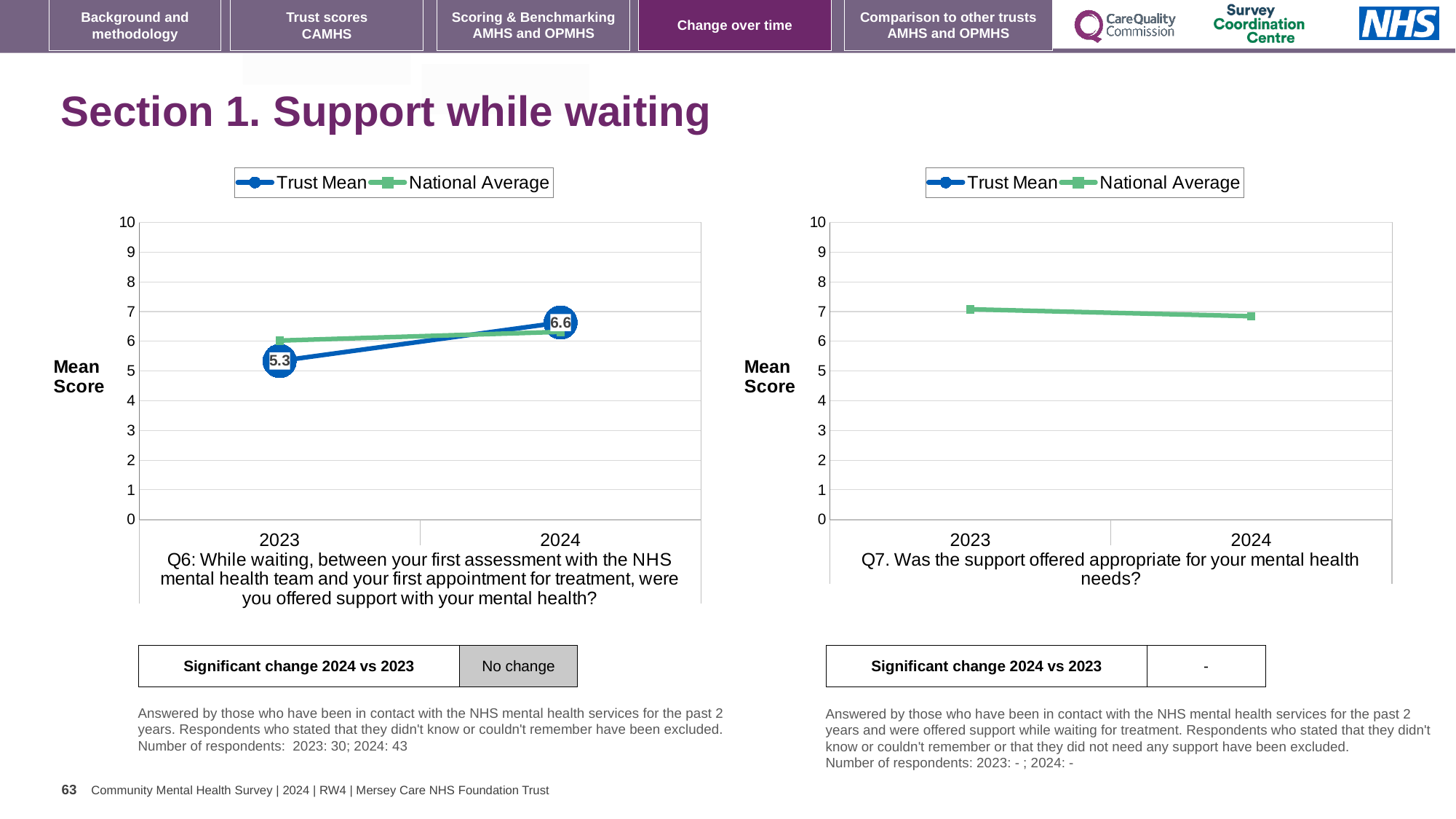
In the left chart (Q6), in 2023, which is higher: the Trust Mean or the National Average? National Average How many series does the legend of the left chart (Q6) list? 2 In the left chart (Q6), which year has the higher Trust Mean, 2023 or 2024? 2024 How many years are shown on the x axis of the right chart (Q7)? 2 In the left chart (Q6), what is the Trust Mean score for 2023? 5.3 In the left chart (Q6), by how much did the Trust Mean increase from 2023 to 2024? 1.3 In the left chart (Q6), does the Trust Mean rise or fall from 2023 to 2024? rises In the left chart (Q6), what is the Trust Mean score for 2024? 6.6 In the right chart (Q7), does the National Average rise or fall from 2023 to 2024? falls In the right chart (Q7), is the National Average for 2023 greater or less than 6? greater What kind of chart is the left chart (Q6)? line chart In the left chart (Q6), is the National Average for 2023 greater or less than 7? less